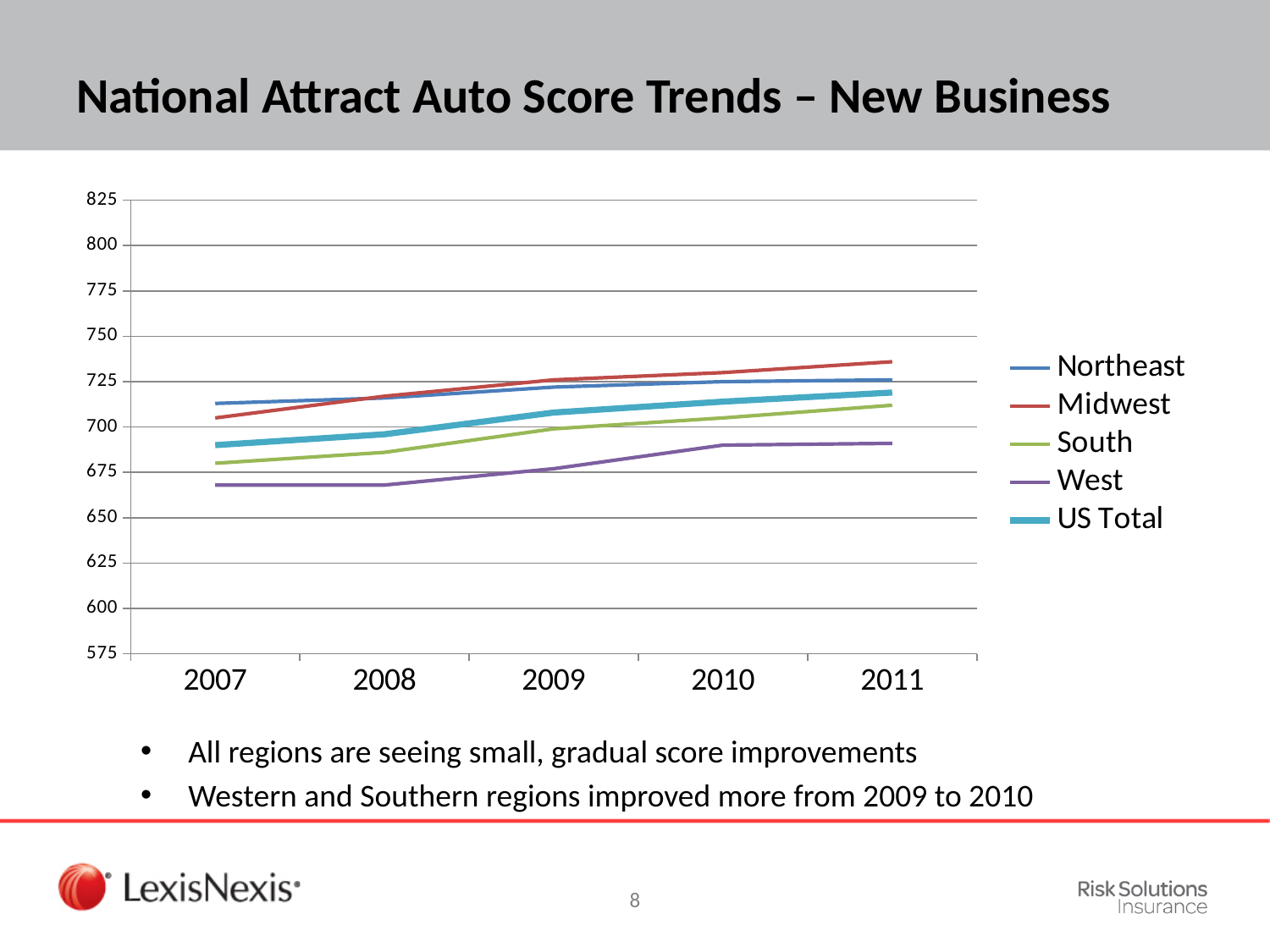
Is the value for Midwest in 2011 greater or less than 725? greater Which series has the lowest value in 2007? West In 2007, which is larger, the Northeast value or the Midwest value? Northeast How many years are plotted along the x axis? 5 In 2010, which is larger, the South value or the West value? South Is the value for West in 2007 greater or less than 675? less Which series has the highest value in 2011? Midwest Is the value for South in 2007 greater or less than 700? less Which series has the lowest value in 2011? West What kind of chart is shown on the slide? line chart Does the Midwest series rise or fall from 2007 to 2011? rise How many series does the legend list? 5